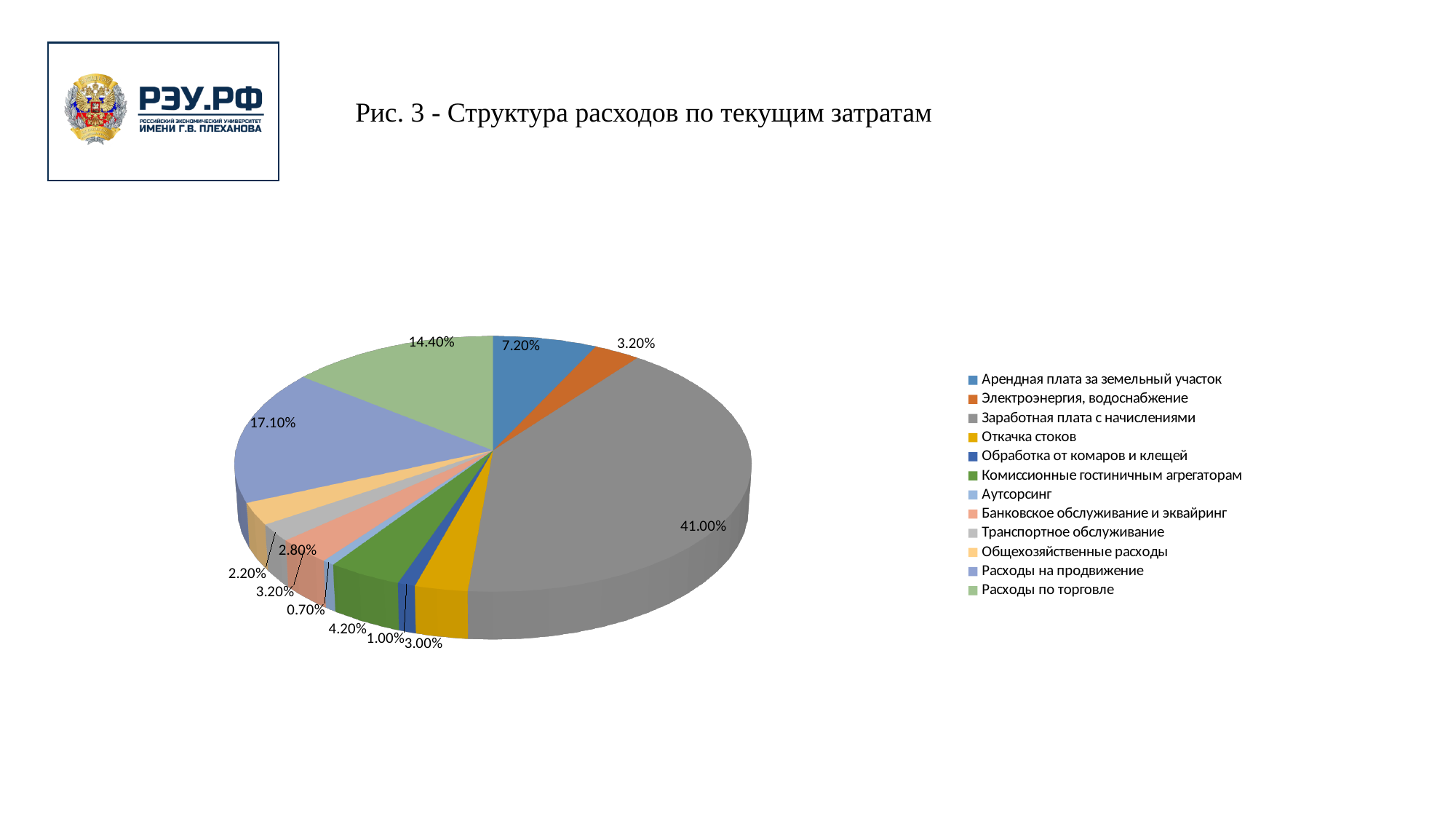
What is the difference in percentage points between Расходы на продвижение and Расходы по торговле? 2.70 What share of current expenses is Расходы на продвижение? 17.10% What is the title of the chart? Рис. 3 - Структура расходов по текущим затратам What share of current expenses is Заработная плата с начислениями? 41.00% Which is larger: the share for Комиссионные гостиничным агрегаторам or the share for Откачка стоков? Комиссионные гостиничным агрегаторам What type of chart is shown on the slide? pie chart Which category has the smallest share of current expenses? Аутсорсинг What share of current expenses is Расходы по торговле? 14.40% How many categories does the pie chart show? 12 What share of current expenses is Аутсорсинг? 0.70% Which category has the largest share of current expenses? Заработная плата с начислениями What share of current expenses is Арендная плата за земельный участок? 7.20%